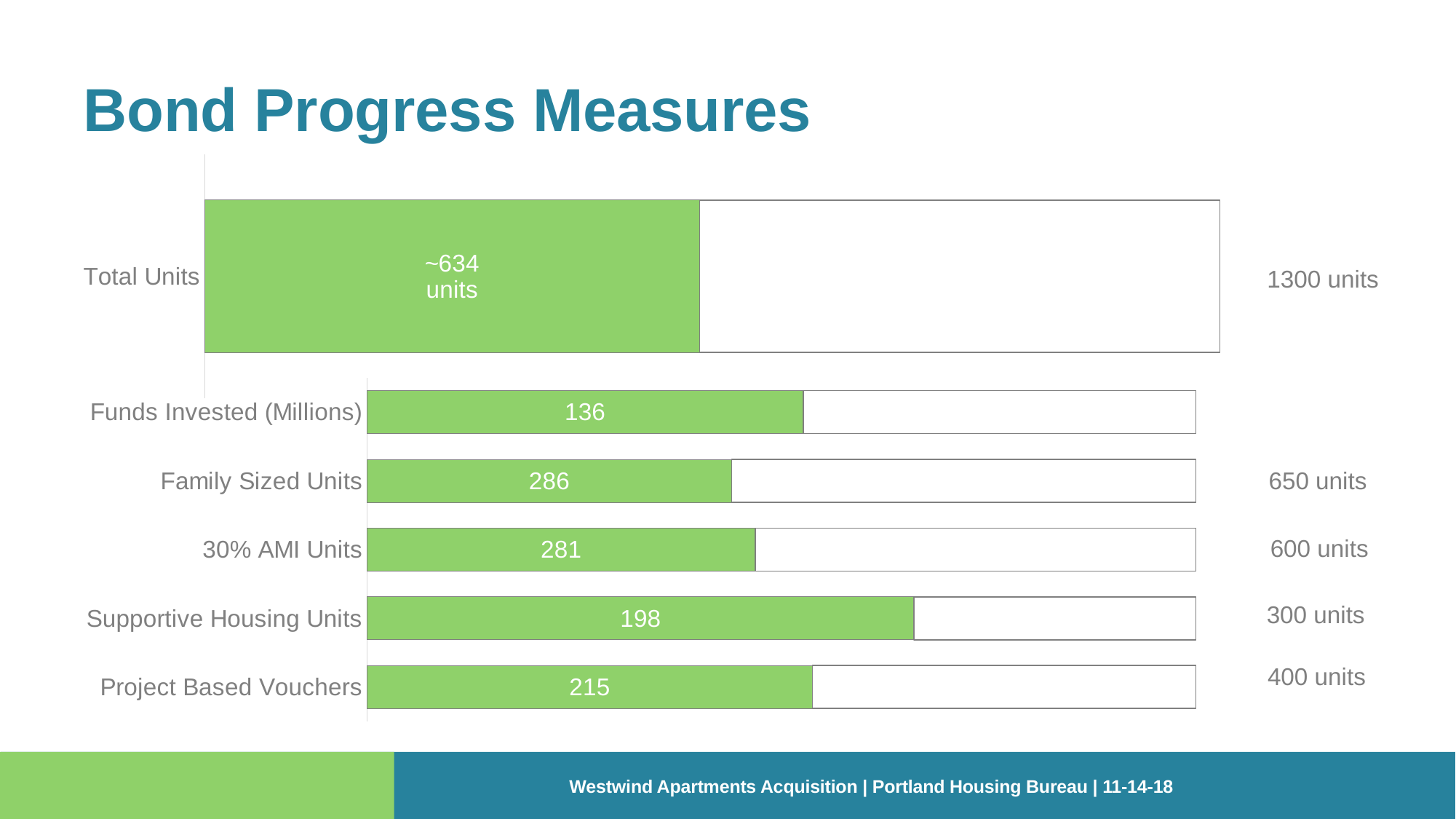
How many categories are shown in the lower chart? 5 In the lower chart, what is the value for Project Based Vouchers? 215 In the lower chart, what is the value for 30% AMI Units? 281 What kind of chart is used on this slide? Bar chart In the lower chart, what is the value for Family Sized Units? 286 In the lower chart, which category has the highest value? Family Sized Units In the lower chart, what is the value for Funds Invested (Millions)? 136 What is the target shown to the right of the Total Units bar? 1300 units In the lower chart, what is the difference between Project Based Vouchers and Supportive Housing Units? 17 In the lower chart, which category has the lowest value? Funds Invested (Millions) In the lower chart, which is larger: Family Sized Units or 30% AMI Units? Family Sized Units In the lower chart, what is the value for Supportive Housing Units? 198